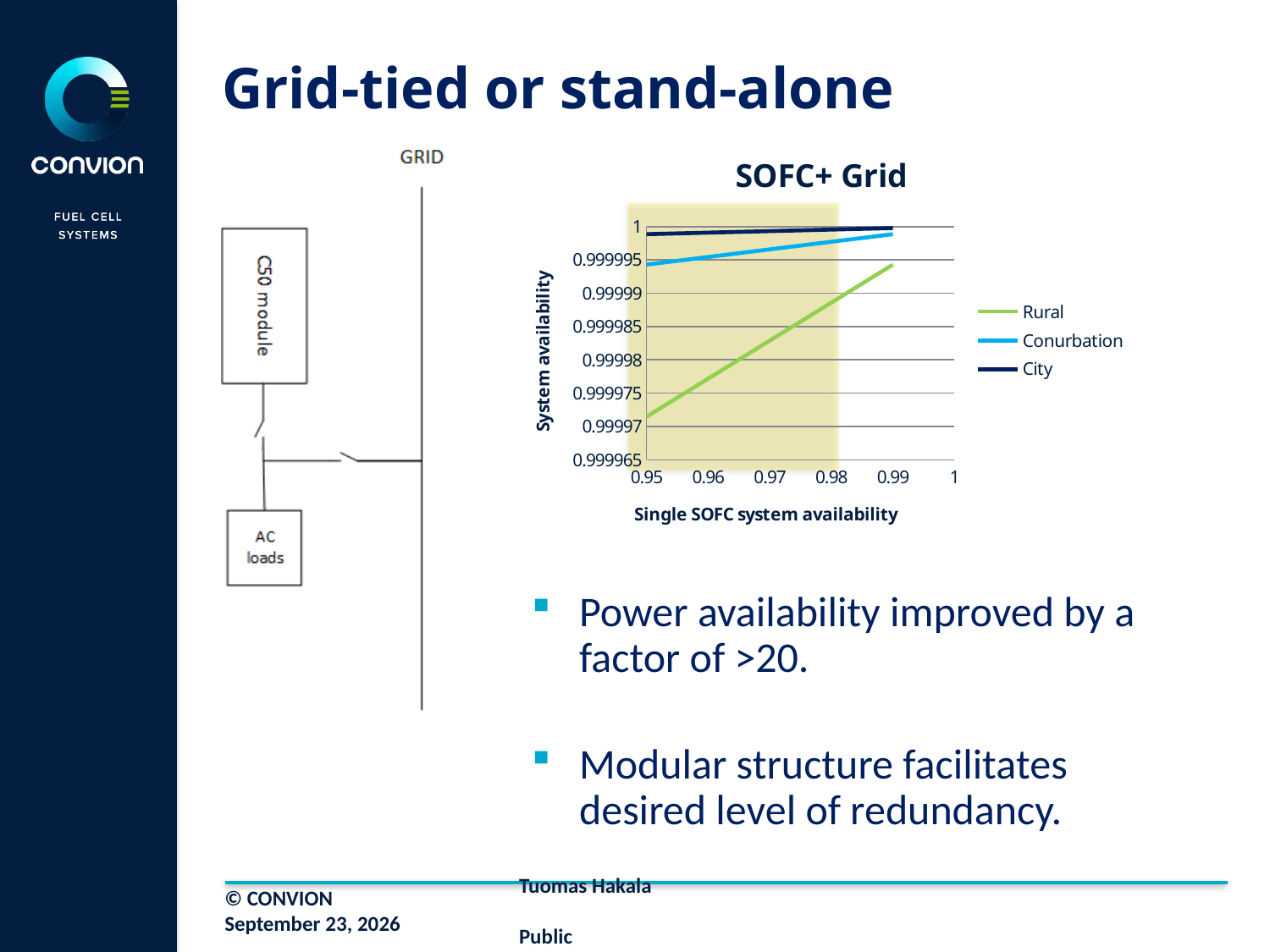
In the "SOFC+ Grid" chart, at a single SOFC system availability of 0.99, is the system availability for Rural greater or less than 0.99999? greater In the "SOFC+ Grid" chart, at a single SOFC system availability of 0.95, which is larger: the system availability for Rural or for City? City What kind of chart is the "SOFC+ Grid" chart? line chart What is the label of the x axis of the "SOFC+ Grid" chart? Single SOFC system availability In the "SOFC+ Grid" chart, at a single SOFC system availability of 0.95, is the system availability for Conurbation greater or less than 0.99999? greater In the "SOFC+ Grid" chart, which series has the lowest system availability at a single SOFC system availability of 0.95? Rural In the "SOFC+ Grid" chart, at a single SOFC system availability of 0.95, is the system availability for Rural greater or less than 0.999975? less In the "SOFC+ Grid" chart, which series has the highest system availability across the plotted range? City How many series does the legend of the "SOFC+ Grid" chart list? 3 What is the title of the chart on the slide? SOFC+ Grid In the "SOFC+ Grid" chart, does the Rural line rise or fall as single SOFC system availability increases? rise In the "SOFC+ Grid" chart, does the Conurbation line rise or fall along the x axis? rise